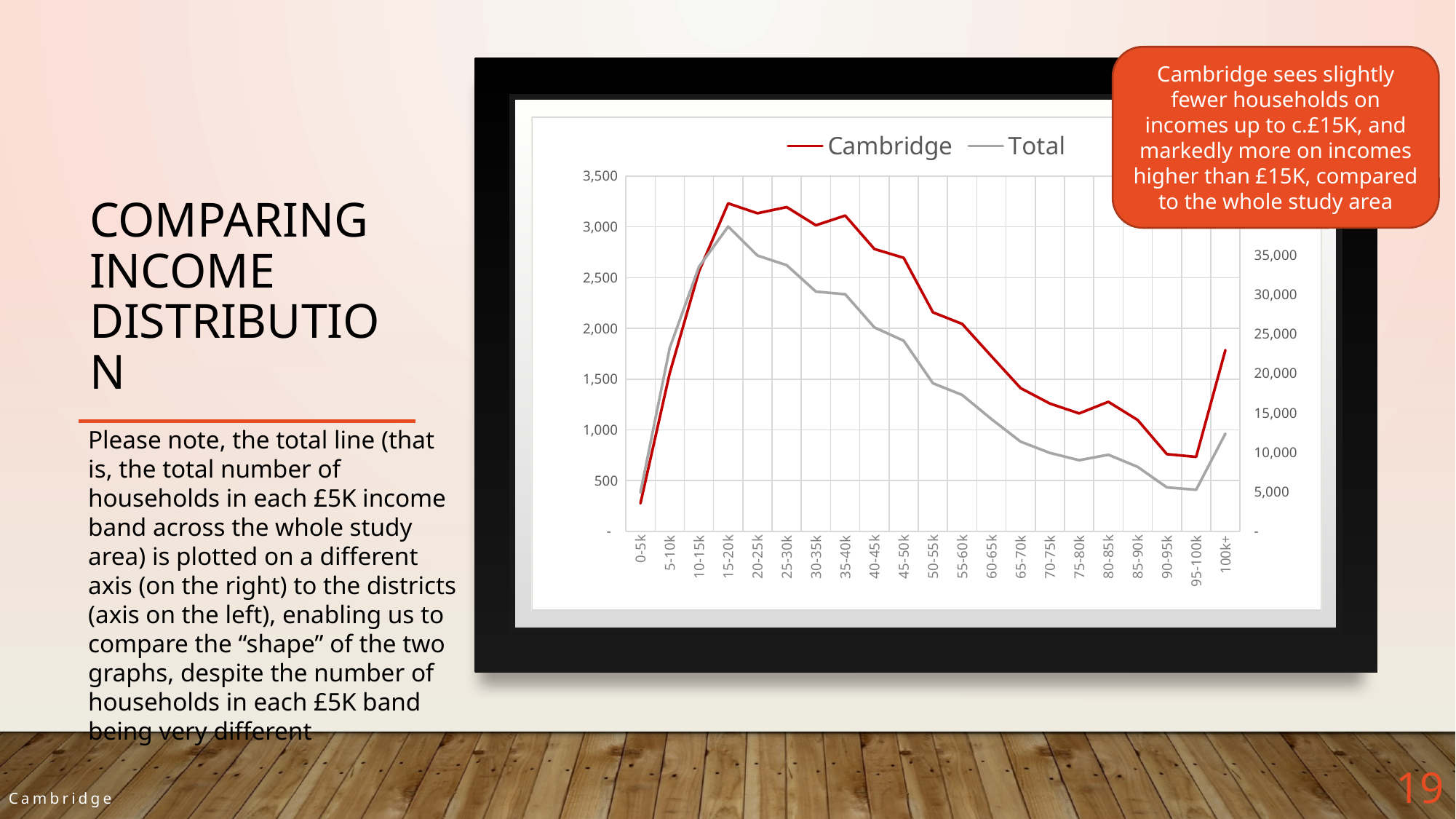
In which income band does the Cambridge line reach its highest value? 15-20k What kind of chart is shown on the slide? Line chart In which income band does the Total line reach its highest value? 15-20k Is the Cambridge value for the 0-5k band greater or less than 500? less Is the Total value for the 100k+ band greater or less than 10,000 on the right-hand axis? greater How many series does the chart legend list? 2 Is the Cambridge value for the 100k+ band greater or less than 1,500? greater In which income band is the Cambridge line at its lowest value? 0-5k For the Cambridge series, which band has the larger value: 40-45k or 50-55k? 40-45k How many income bands are shown along the x axis of the chart? 21 What are the two series named in the chart legend? Cambridge and Total